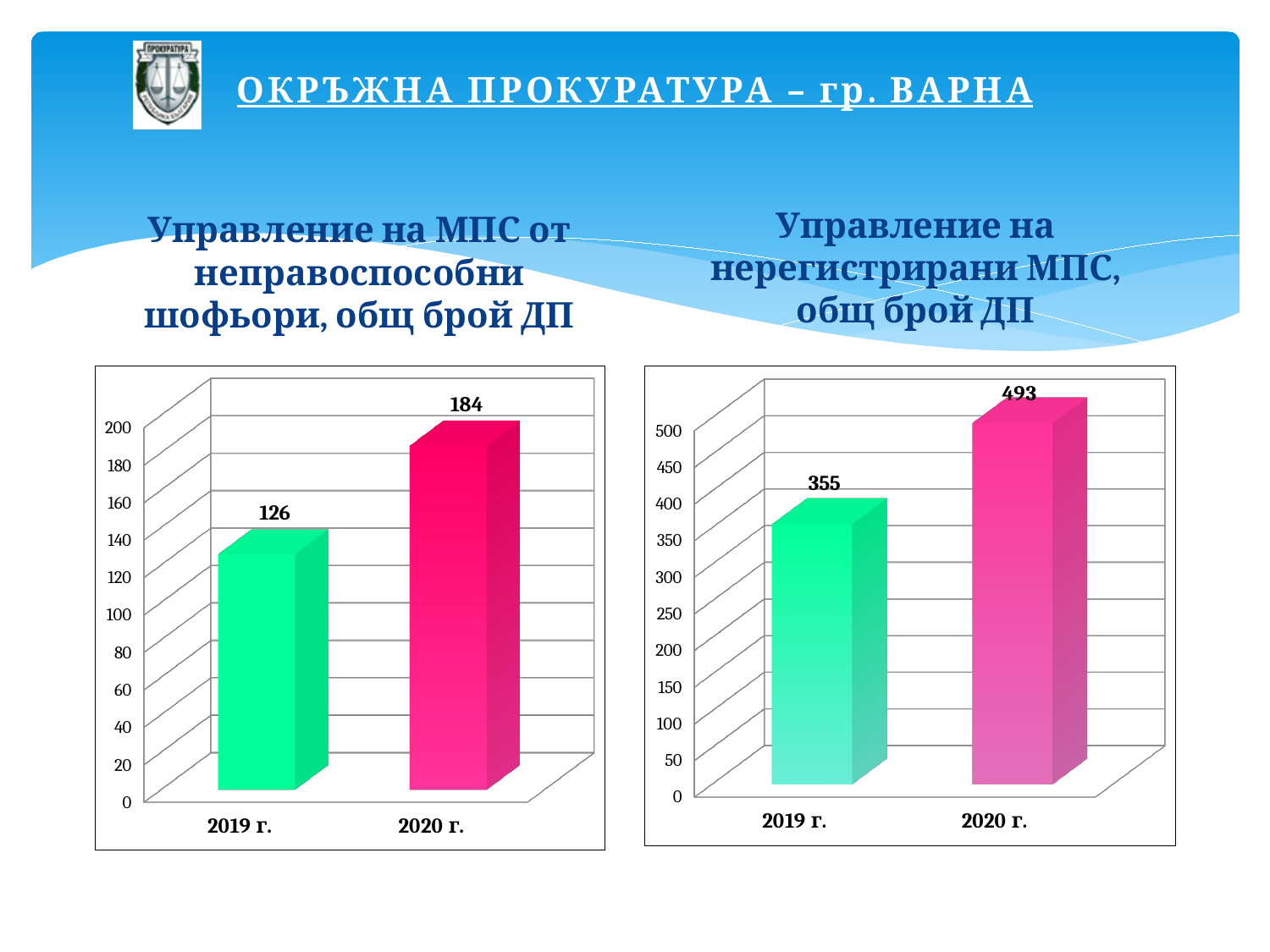
In the right chart, which year has the lower value? 2019 г. What kind of chart is the right chart? bar chart In the left chart (Управление на МПС от неправоспособни шофьори), what is the value for 2020 г.? 184 In the left chart, do the values rise or fall from 2019 г. to 2020 г.? rise In the right chart (Управление на нерегистрирани МПС), what is the value for 2020 г.? 493 In the right chart, is the value for 2019 г. greater or less than 300? greater In the right chart (Управление на нерегистрирани МПС), what is the value for 2019 г.? 355 In the left chart, which year has the higher value? 2020 г. In the left chart, what is the difference between the 2020 г. and 2019 г. values? 58 In the right chart, what is the difference between the 2020 г. and 2019 г. values? 138 In the left chart (Управление на МПС от неправоспособни шофьори), what is the value for 2019 г.? 126 How many categories are shown on the x axis of the left chart? 2